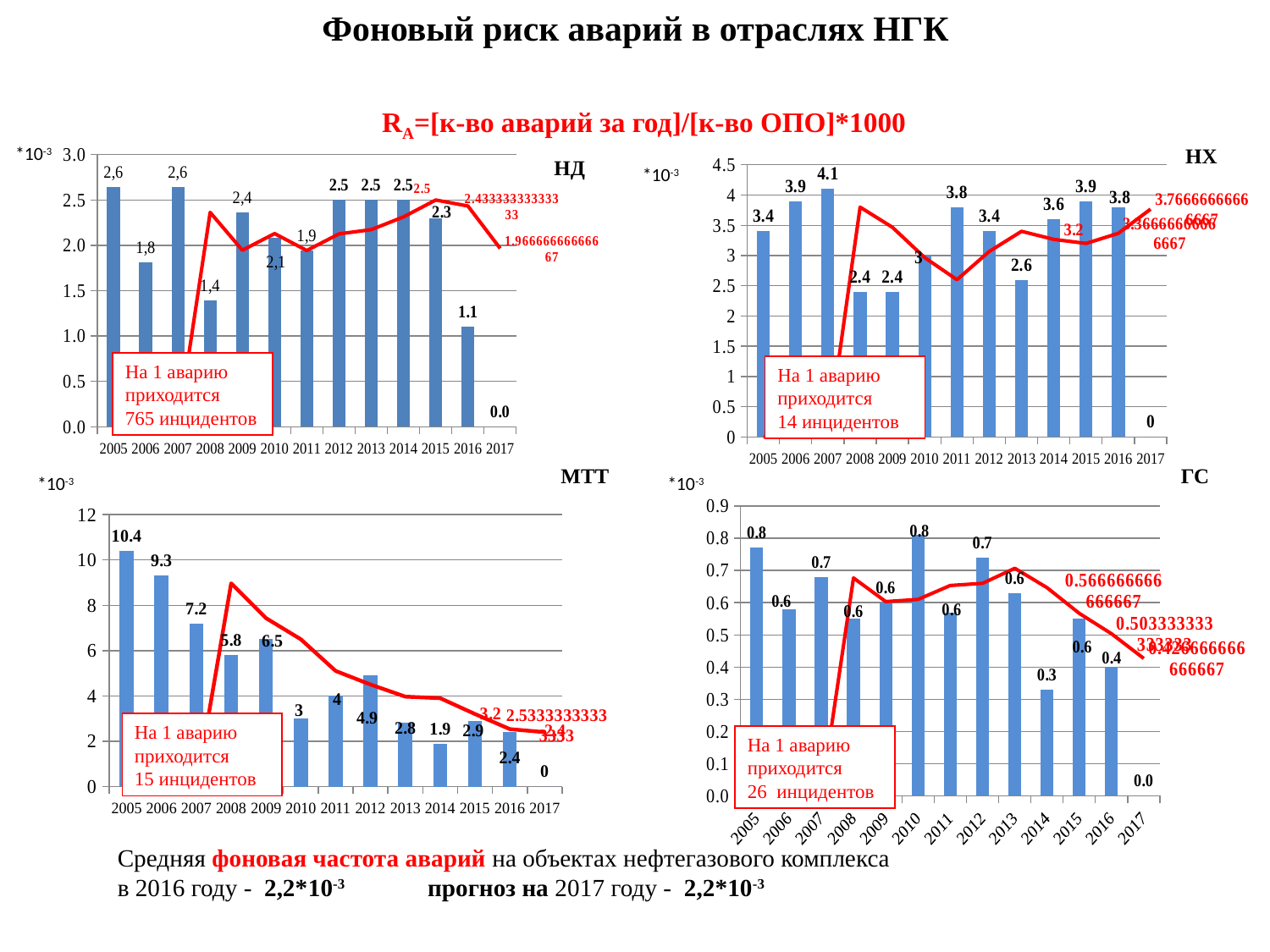
In the МТТ chart (bottom left), which year has the highest bar? 2005 In the ГС chart (bottom right), which year has the lowest bar? 2014 In the ГС chart (bottom right), what is the value for 2014? 0.3 In the НД chart (top left), what is the value for 2016? 1.1 In the НХ chart (top right), what is the value for 2011? 3.8 In the МТТ chart (bottom left), what is the difference between the values for 2005 and 2006? 1.1 What kind of chart is the МТТ chart (bottom left)? bar chart with a line In the МТТ chart (bottom left), do the bar values generally rise or fall from 2005 to 2016? fall In the НХ chart (top right), which year has the highest bar? 2007 In the НД chart (top left), which year has the larger value, 2009 or 2010? 2009 In the МТТ chart (bottom left), what is the value for 2012? 4.9 How many years are shown on the x axis of the НХ chart (top right)? 13